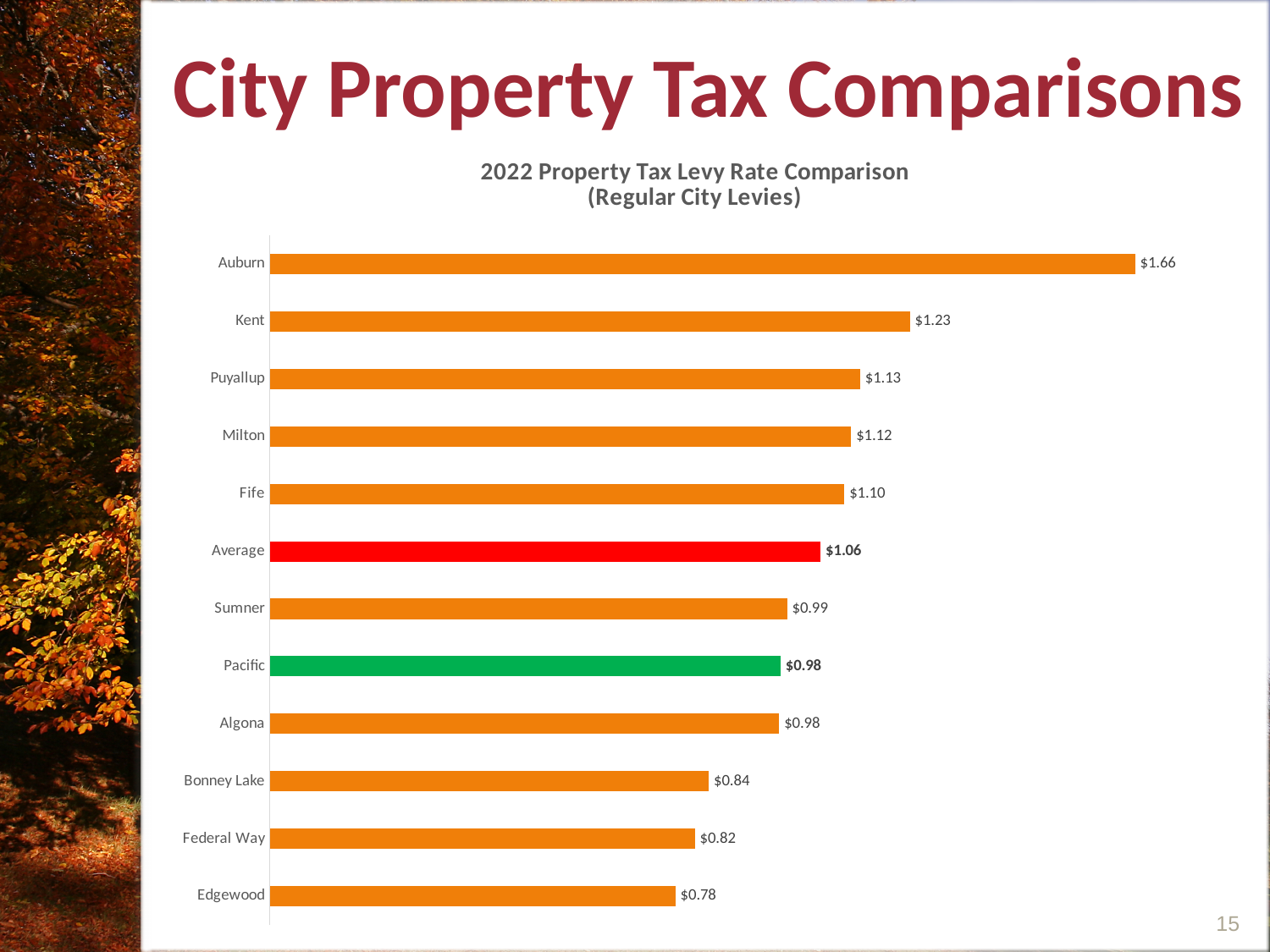
What is the difference between Auburn's levy rate and Kent's levy rate? $0.43 What type of chart is shown on the slide? Bar chart What value is shown for the Average bar? $1.06 Which has a higher levy rate, Bonney Lake or Federal Way? Bonney Lake Which city has the lowest levy rate on the chart? Edgewood What is the levy rate shown for Pacific? $0.98 How many bars are plotted on the chart, including the Average bar? 12 Which bar on the chart is coloured green? Pacific What is the difference between the Average levy rate and Pacific's levy rate? $0.08 Which city has the highest levy rate on the chart? Auburn Which has a higher levy rate, Puyallup or Fife? Puyallup What is the 2022 property tax levy rate shown for Auburn? $1.66